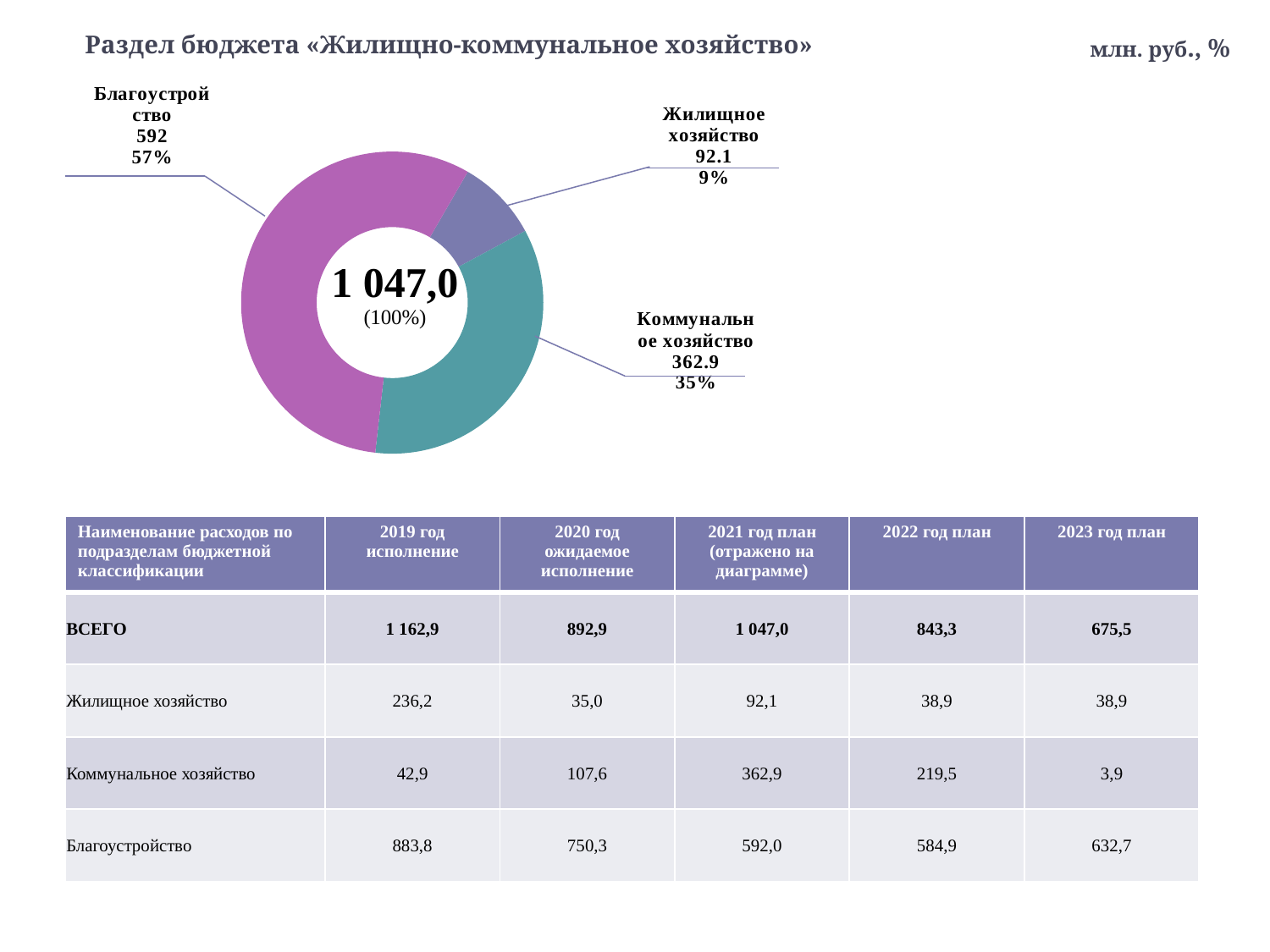
Which category has the smallest slice in the chart? Жилищное хозяйство What is the value shown for Жилищное хозяйство in the chart? 92.1 What is the value shown for Коммунальное хозяйство in the chart? 362.9 What share of the chart does Жилищное хозяйство represent? 9% What is the value shown for Благоустройство in the chart? 592 What total value is shown in the centre of the chart? 1 047,0 Which is larger in the chart, Коммунальное хозяйство or Жилищное хозяйство? Коммунальное хозяйство What share of the chart does Коммунальное хозяйство represent? 35% Which category has the largest slice in the chart? Благоустройство What kind of chart is shown on the slide? Donut (pie) chart How many categories (slices) does the chart show? 3 What share of the chart does Благоустройство represent? 57%